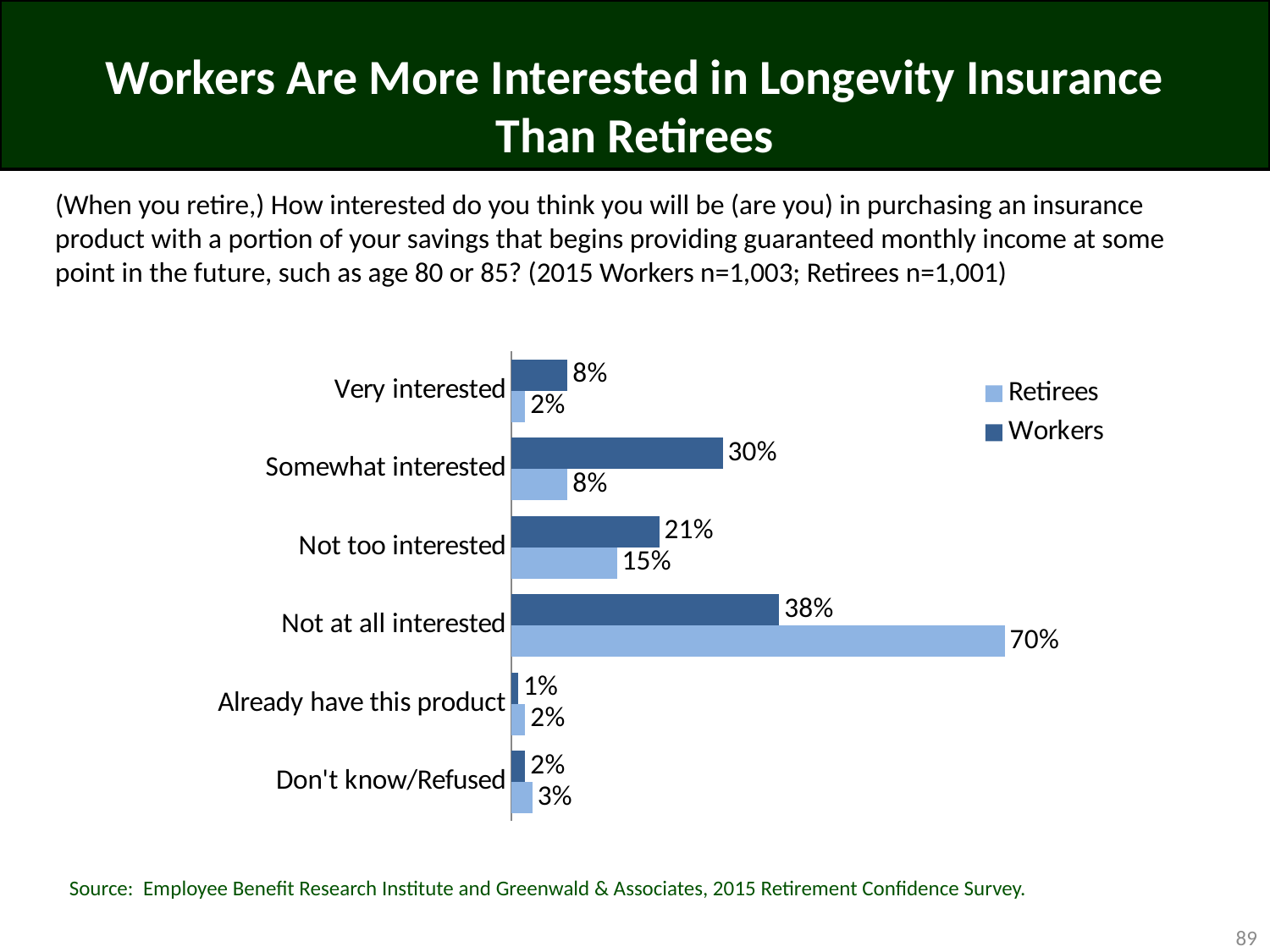
How many series does the legend list? 2 How many response categories are shown on the chart? 6 For "Not too interested", which group has the larger value, Workers or Retirees? Workers What percentage of Retirees are "Not too interested"? 15% What is the difference between the Retirees and Workers values for "Not at all interested"? 32% What is the difference between the Workers and Retirees values for "Somewhat interested"? 22% What type of chart is shown on the slide? Bar chart What percentage of Retirees are "Not at all interested"? 70% What percentage of Workers are "Very interested"? 8% Which category has the lowest value for Workers? Already have this product Which category has the highest value for Retirees? Not at all interested What percentage of Workers are "Somewhat interested"? 30%